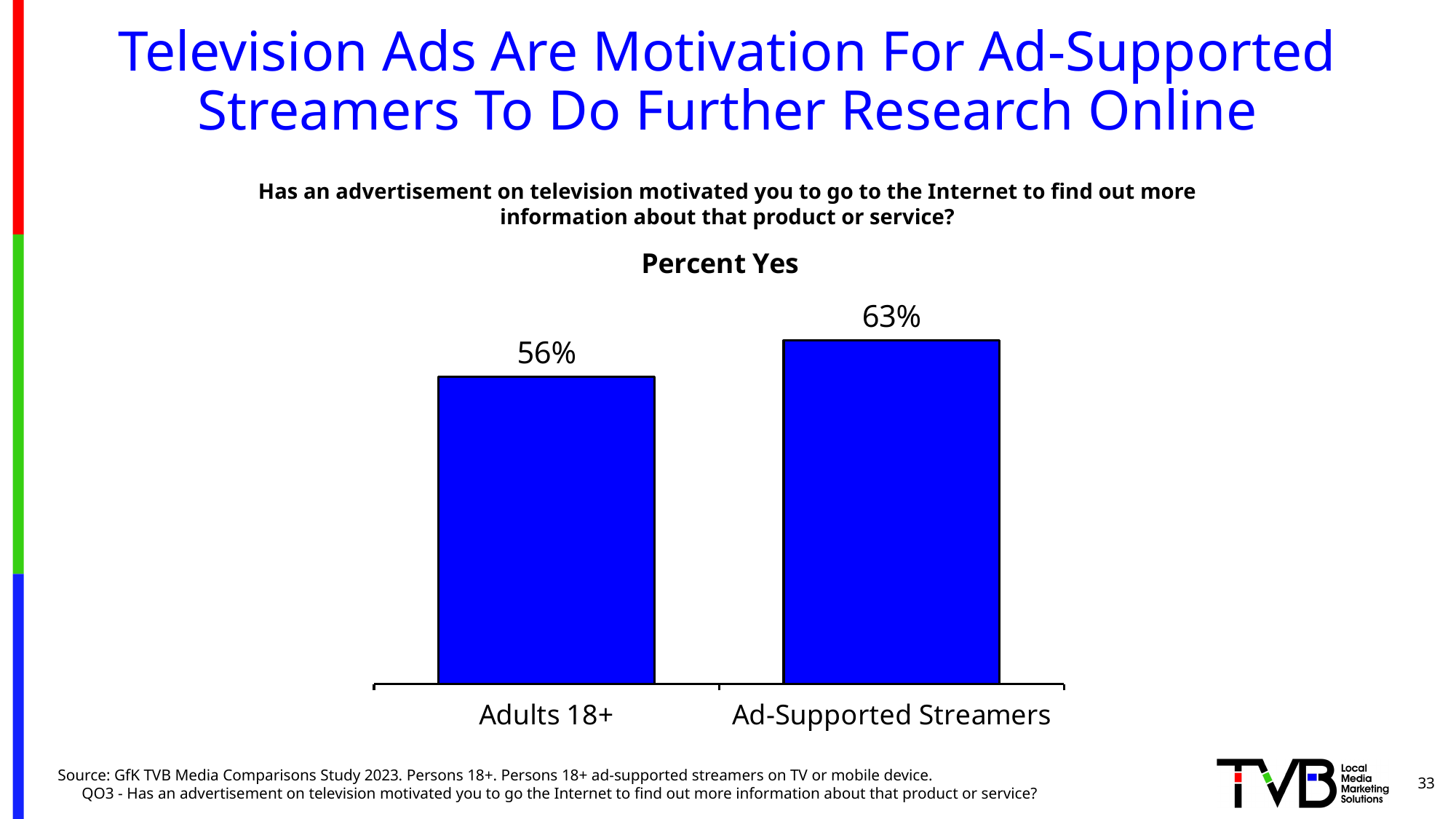
What is the Percent Yes value for Adults 18+? 56% Which category has the higher Percent Yes value? Ad-Supported Streamers How many categories are shown in the chart? 2 What is the difference in Percent Yes between Ad-Supported Streamers and Adults 18+? 7 percentage points What is the title of the chart? Percent Yes What is the Percent Yes value for Ad-Supported Streamers? 63% What kind of chart is shown on the slide? Bar chart What colour are the bars in the chart? Blue Is the Percent Yes value larger for Adults 18+ or for Ad-Supported Streamers? Ad-Supported Streamers Which category has the lower Percent Yes value? Adults 18+